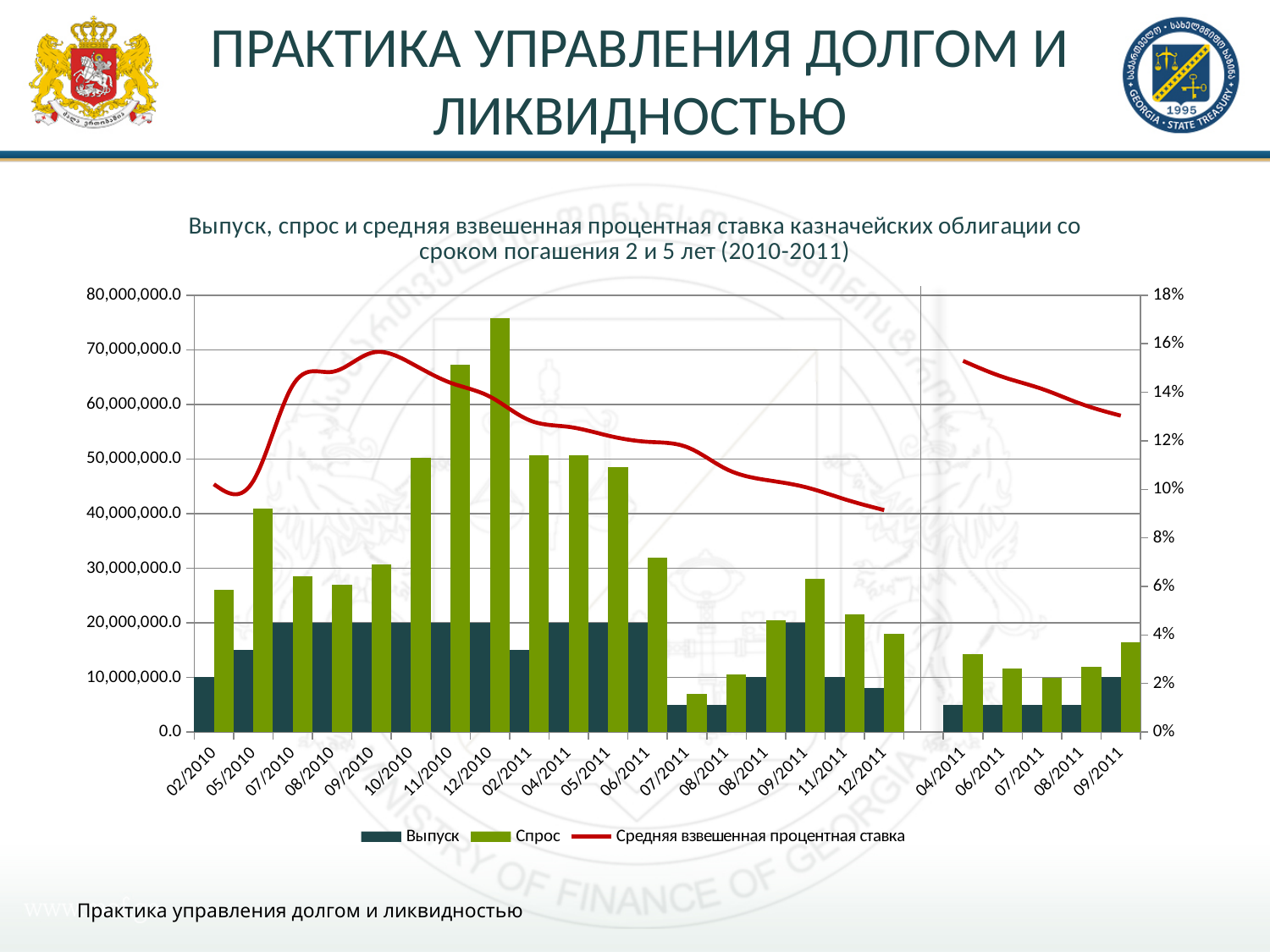
Is the Средняя взвешенная процентная ставка value for 09/2010 greater or less than 14%? greater What is the value of Выпуск for 02/2010? 10,000,000.0 Is the Спрос value for 12/2010 greater or less than 70,000,000.0? greater How many series does the chart legend list? 3 What is the value of Выпуск for 07/2010? 20,000,000.0 What colour are the Спрос bars? Green Does the Средняя взвешенная процентная ставка line rise or fall from 04/2011 to 09/2011 in the right-hand group of categories? Falls What kind of chart is shown on the slide? Bar chart with a line Which category has the highest Спрос value? 12/2010 Which is larger, the Спрос value for 02/2010 or for 05/2010? 05/2010 What is the title of the chart? Выпуск, спрос и средняя взвешенная процентная ставка казначейских облигации со сроком погашения 2 и 5 лет (2010-2011) Is the Спрос value for 11/2010 greater or less than 60,000,000.0? greater